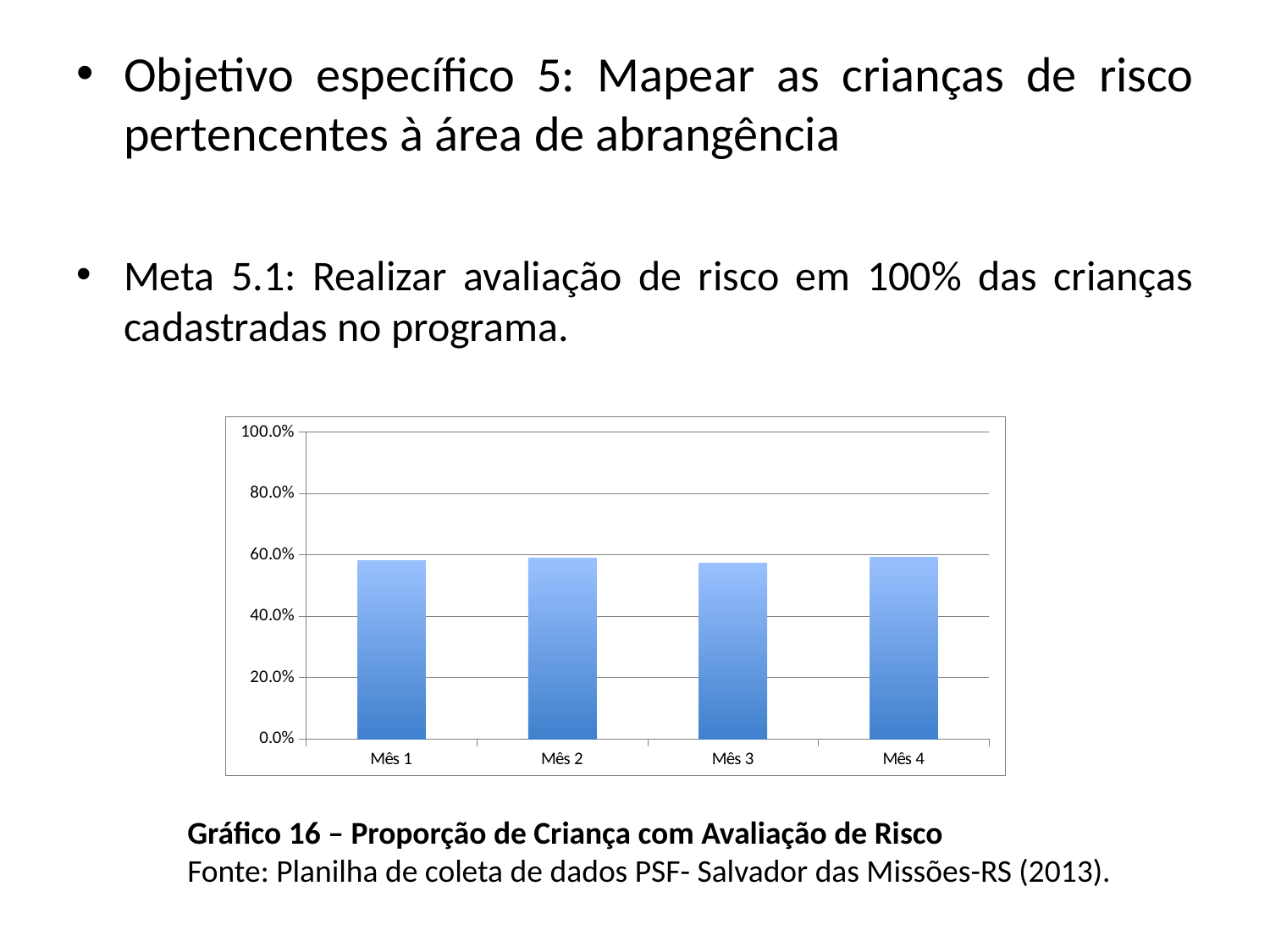
Do any of the bars in the chart reach the 100.0% line? No Is the value for Mês 2 greater or less than 40.0%? greater What is the title given for the chart in the caption below it? Gráfico 16 – Proporção de Criança com Avaliação de Risco Is the value for Mês 3 greater or less than 60.0%? less What kind of chart is shown on the slide? bar chart What is the label of the first category on the x axis? Mês 1 What is the highest value shown on the y axis of the chart? 100.0% How many categories (months) are shown on the x axis of the chart? 4